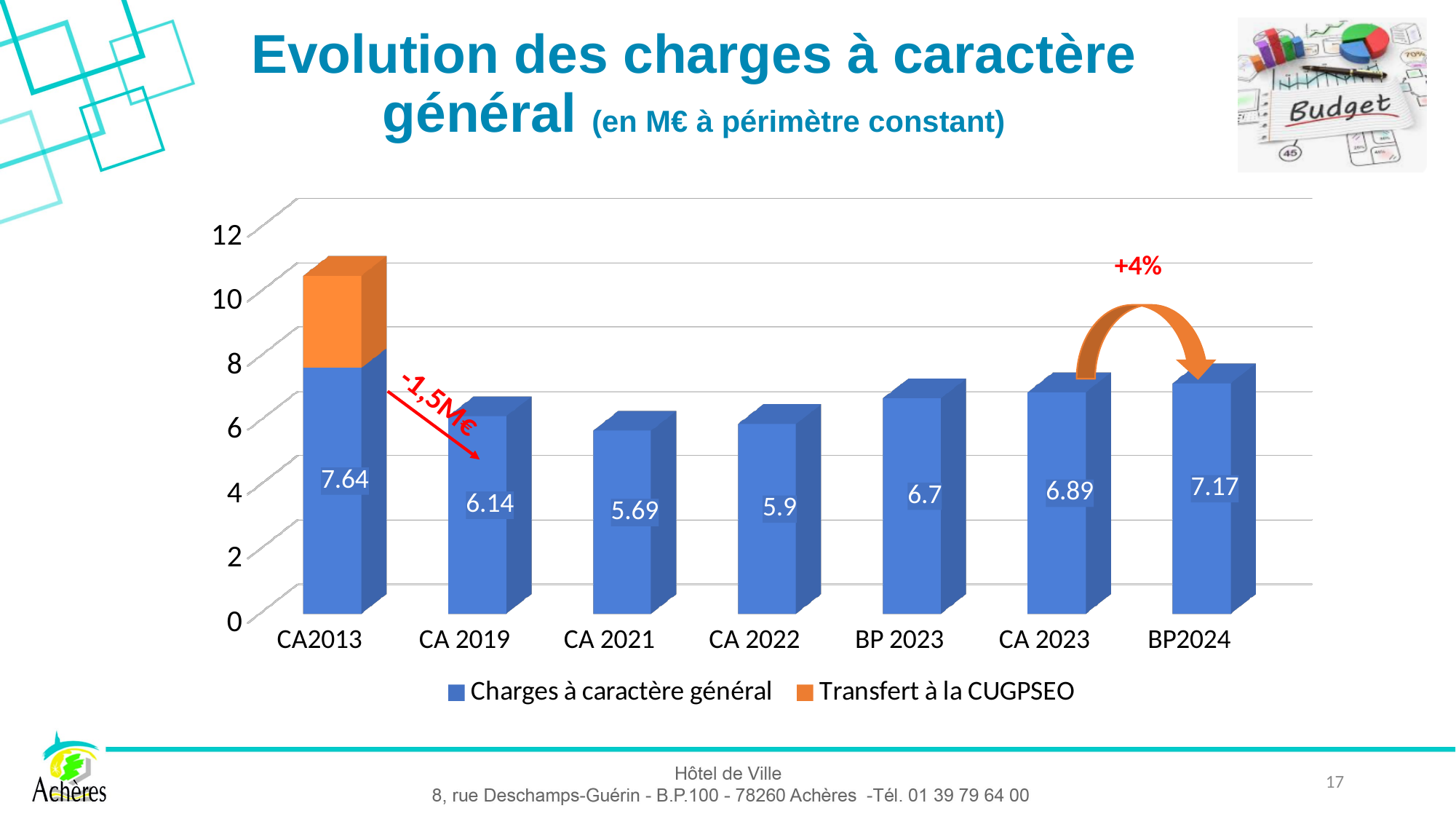
How many series does the legend list? 2 What is the difference between the Charges à caractère général values for BP2024 and CA 2023? 0.28 Do the Charges à caractère général values rise or fall from CA 2021 to BP2024? Rise Which category has the highest value for Charges à caractère général? CA2013 What percentage change is annotated between CA 2023 and BP2024? +4% What is the value of Charges à caractère général for CA 2022? 5.9 What is the value of Charges à caractère général for CA2013? 7.64 Which category has the lowest value for Charges à caractère général? CA 2021 What kind of chart is shown on the slide? Bar chart Which is larger, the Charges à caractère général value for BP 2023 or for CA 2019? BP 2023 How many categories are shown on the x axis? 7 What is the value of Charges à caractère général for BP2024? 7.17